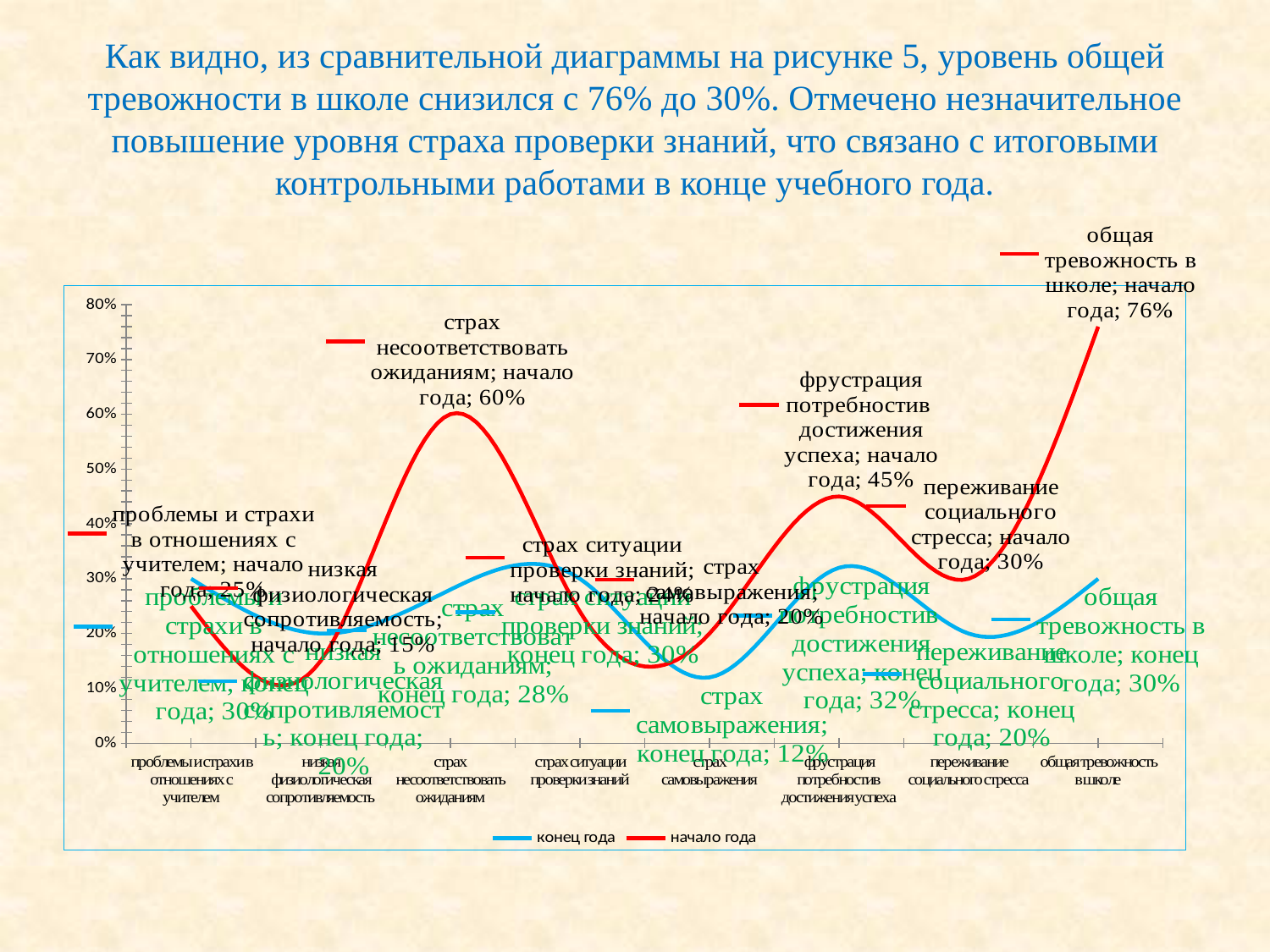
What is the value for 'общая тревожность в школе' in the 'начало года' series? 76% For 'фрустрация потребностив достижения успеха', which series has the larger value: 'начало года' or 'конец года'? начало года Which colour is used for the 'конец года' series line? blue Which category has the lowest value in the 'конец года' series? страх самовыражения How many categories are plotted along the x axis of the chart? 8 How many series does the chart legend list? 2 What is the difference between the 'начало года' and 'конец года' values for 'общая тревожность в школе'? 46% What is the value for 'страх самовыражения' in the 'конец года' series? 12% What is the value for 'страх несоответствовать ожиданиям' in the 'начало года' series? 60% What is the value for 'общая тревожность в школе' in the 'конец года' series? 30% What type of chart is shown on the slide? line chart Which category has the highest value in the 'начало года' series? общая тревожность в школе